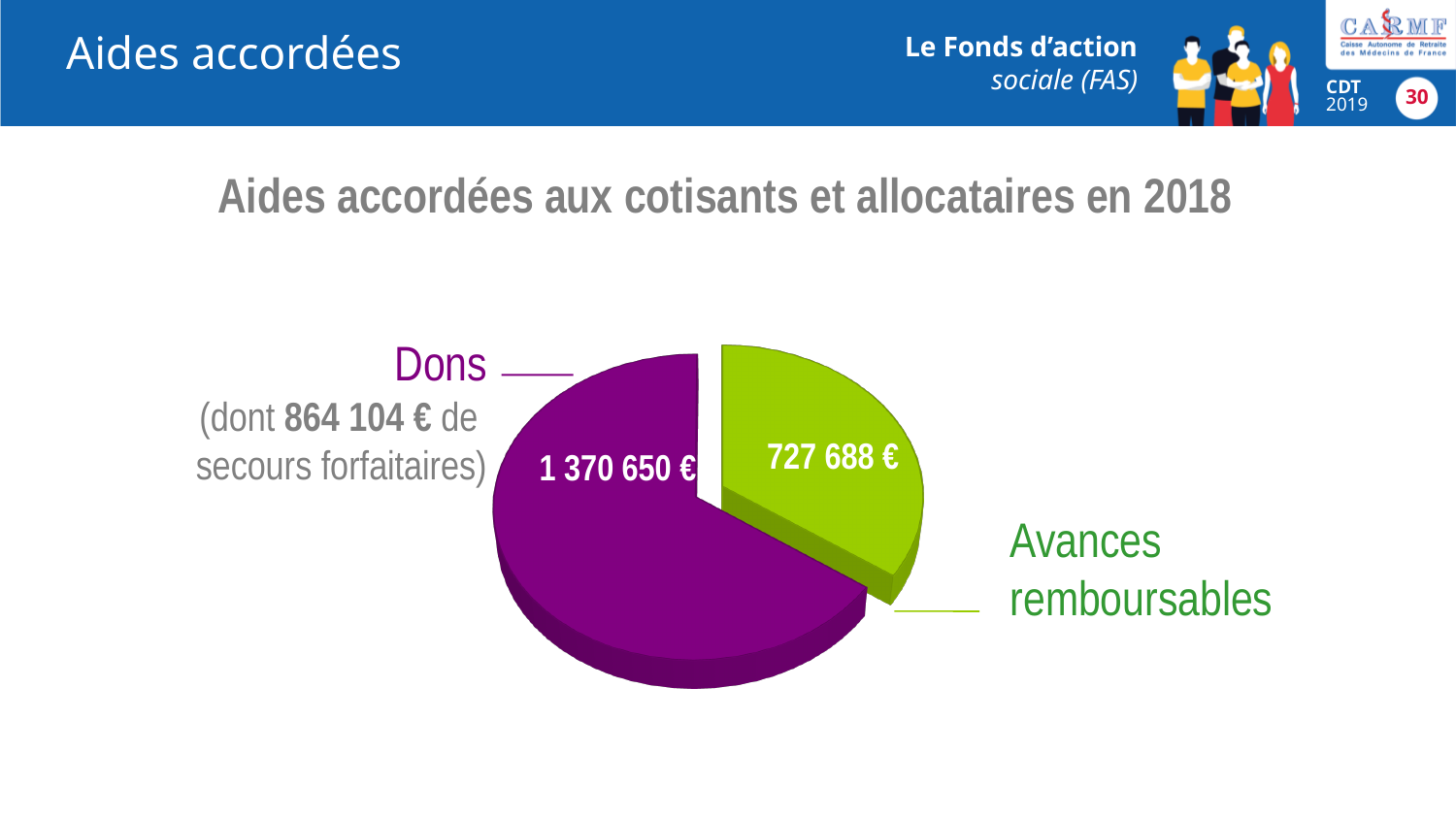
What is the value of the Avances remboursables slice? 727 688 € What is the difference between the Dons value and the Avances remboursables value? 642 962 € What is the total of the two slices in the pie chart? 2 098 338 € Which is larger, Dons or Avances remboursables? Dons How many slices does the pie chart have? 2 What is the value of the Dons slice? 1 370 650 € Which category has the largest slice of the pie? Dons Which category has the smallest slice of the pie? Avances remboursables What is the title of the chart? Aides accordées aux cotisants et allocataires en 2018 What colour is the Avances remboursables slice? Green What type of chart is shown on the slide? Pie chart According to the label, how much of the Dons amount corresponds to secours forfaitaires? 864 104 €